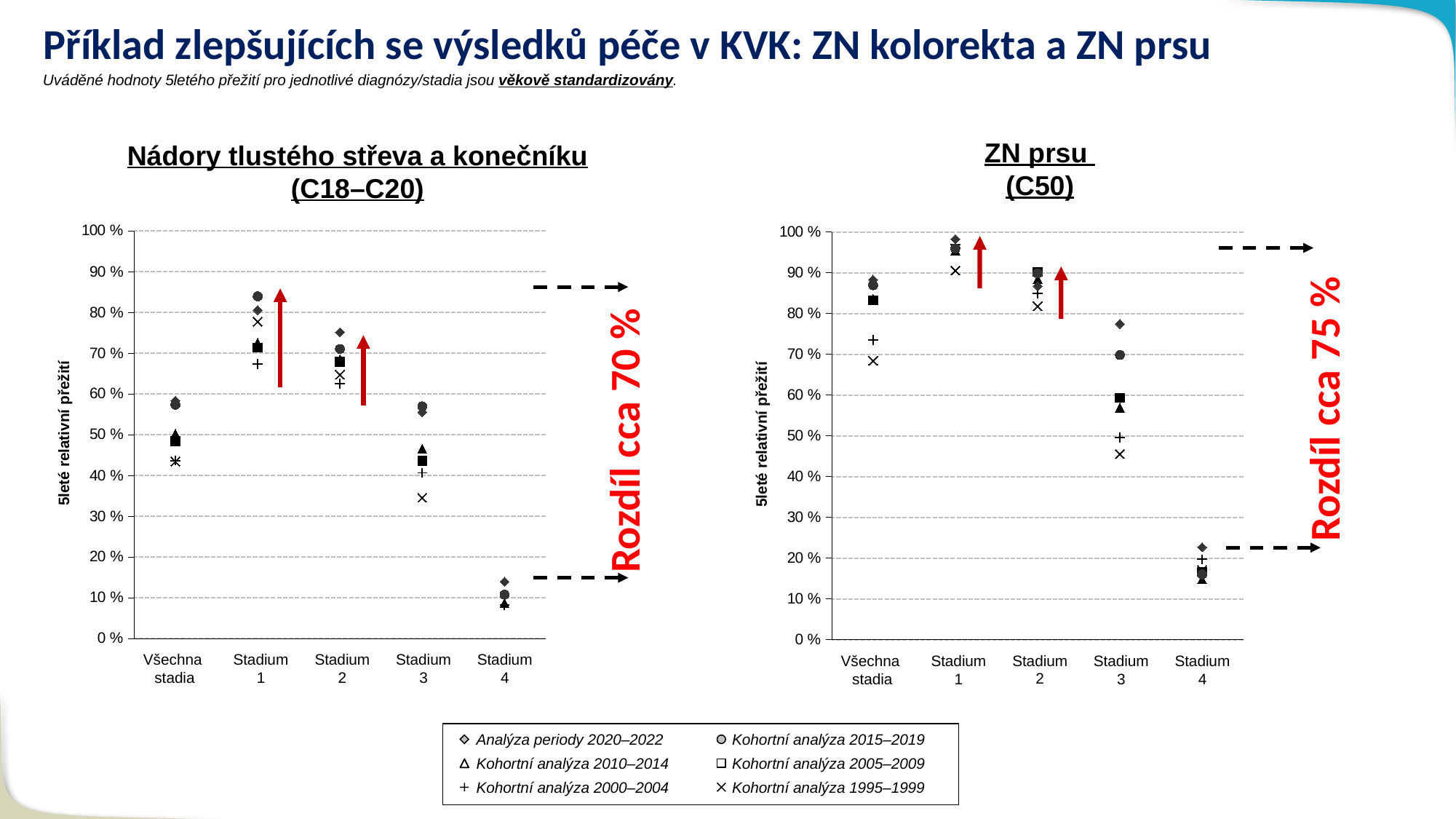
What kind of chart is the left chart (C18–C20)? scatter chart In the right chart (ZN prsu, C50), is the value for Stadium 1 in the Kohortní analýza 1995–1999 series greater or less than 80 %? greater What red annotation is written next to the right chart (ZN prsu, C50)? Rozdíl cca 75 % In the left chart (C18–C20), is the value for Stadium 4 in the Analýza periody 2020–2022 series greater or less than 20 %? less In the left chart (C18–C20), for the Analýza periody 2020–2022 series, which is larger: Stadium 2 or Stadium 3? Stadium 2 In the right chart (ZN prsu, C50), which stage has the highest 5-year relative survival values? Stadium 1 In the left chart (C18–C20), is the value for Stadium 1 in the Kohortní analýza 2015–2019 series greater or less than 80 %? greater In the left chart (C18–C20), which stage has the lowest 5-year relative survival values? Stadium 4 In the right chart (ZN prsu, C50), for Stadium 3, which series has the larger value: Analýza periody 2020–2022 or Kohortní analýza 1995–1999? Analýza periody 2020–2022 How many series does the shared legend list? 6 How many categories are shown on the x axis of the right chart (ZN prsu, C50)? 5